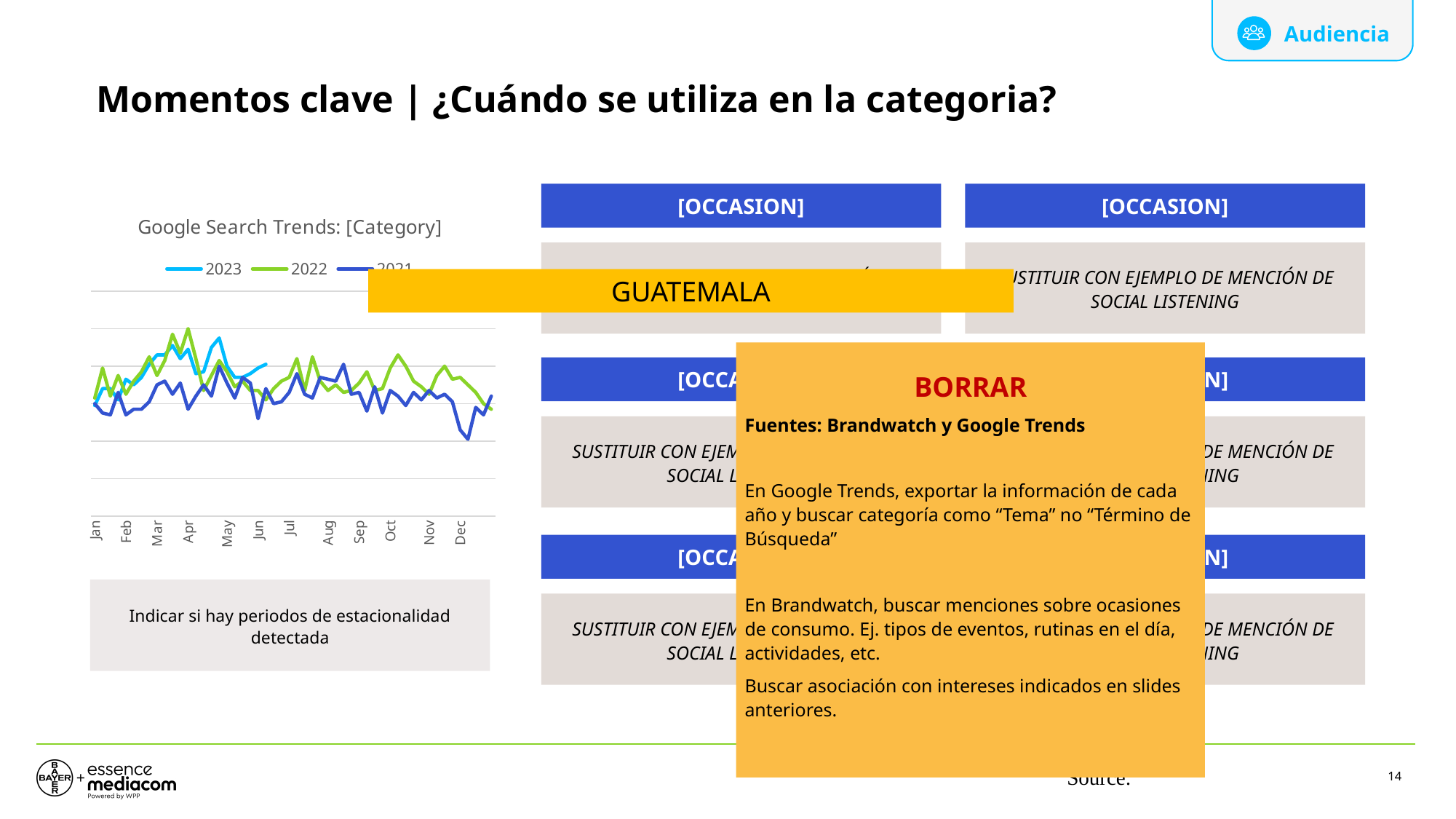
How many series does the chart legend list? 3 What kind of chart is shown on the slide? line chart How many months are labelled along the x axis of the chart? 12 What is the first month label on the x axis of the chart? Jan Which series reaches the lowest point on the chart, in December? 2021 Which series stops partway through the year, ending around June? 2023 Which year is plotted with the green line in the chart? 2022 What is the title of the chart? Google Search Trends: [Category] What is the last month label on the x axis of the chart? Dec